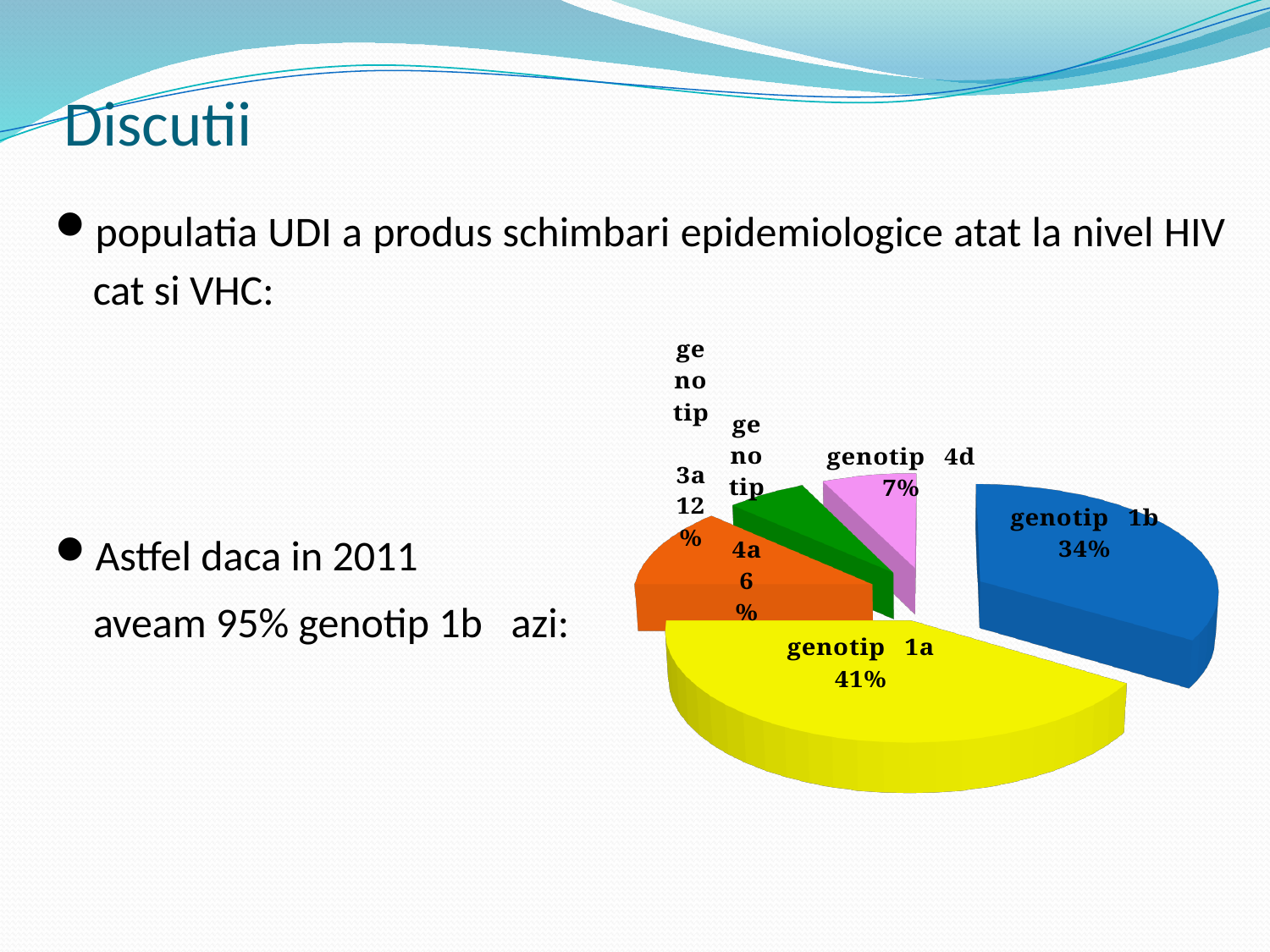
Which is larger, the share for genotip 3a or the share for genotip 4d? genotip 3a How many slices does the pie chart have? 5 Which genotype has the smallest slice of the pie? genotip 4a What share of the pie does genotip 1b have? 34% Which genotype has the largest slice of the pie? genotip 1a What share of the pie does genotip 3a have? 12% What share of the pie does genotip 4a have? 6% What share of the pie does genotip 4d have? 7% What is the difference in percentage points between genotip 1a and genotip 1b? 7 What kind of chart is shown on the slide? pie chart What share of the pie does genotip 1a have? 41% What colour is the slice for genotip 1a? yellow